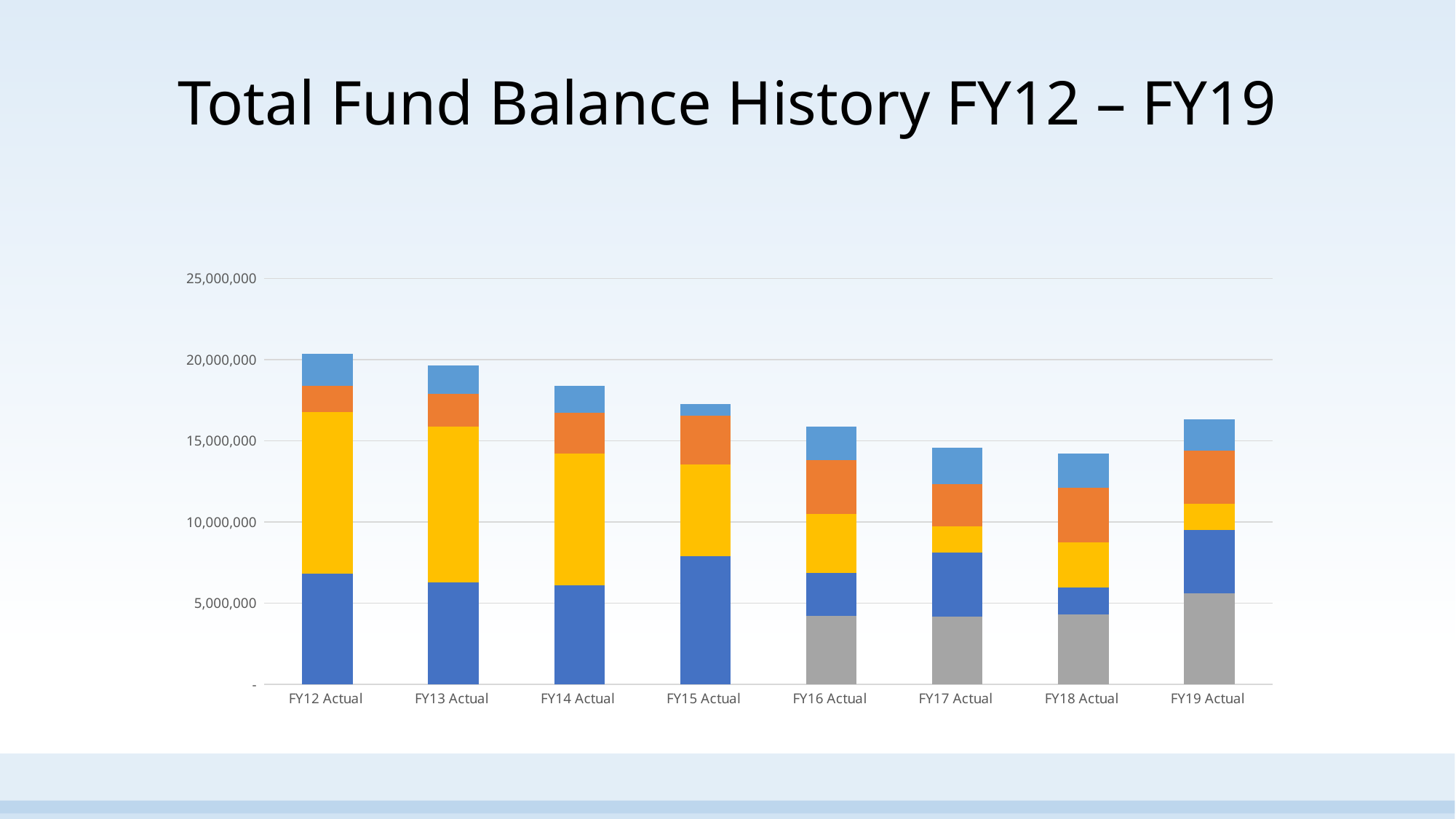
Is the total bar for FY18 Actual greater or less than 15,000,000? less Is the total bar for FY16 Actual greater or less than 15,000,000? greater In which fiscal year does the gray segment first appear at the bottom of the bars? FY16 Actual What is the title of the slide? Total Fund Balance History FY12 – FY19 Is the total bar for FY15 Actual greater or less than 20,000,000? less Which has the larger total fund balance, FY12 Actual or FY19 Actual? FY12 Actual Which fiscal year has the highest total fund balance? FY12 Actual How many fiscal-year categories are plotted on the x axis? 8 What kind of chart is shown on the slide? Stacked bar chart Which has the larger total fund balance, FY15 Actual or FY16 Actual? FY15 Actual Do the total bar heights generally rise or fall from FY12 Actual to FY18 Actual? fall